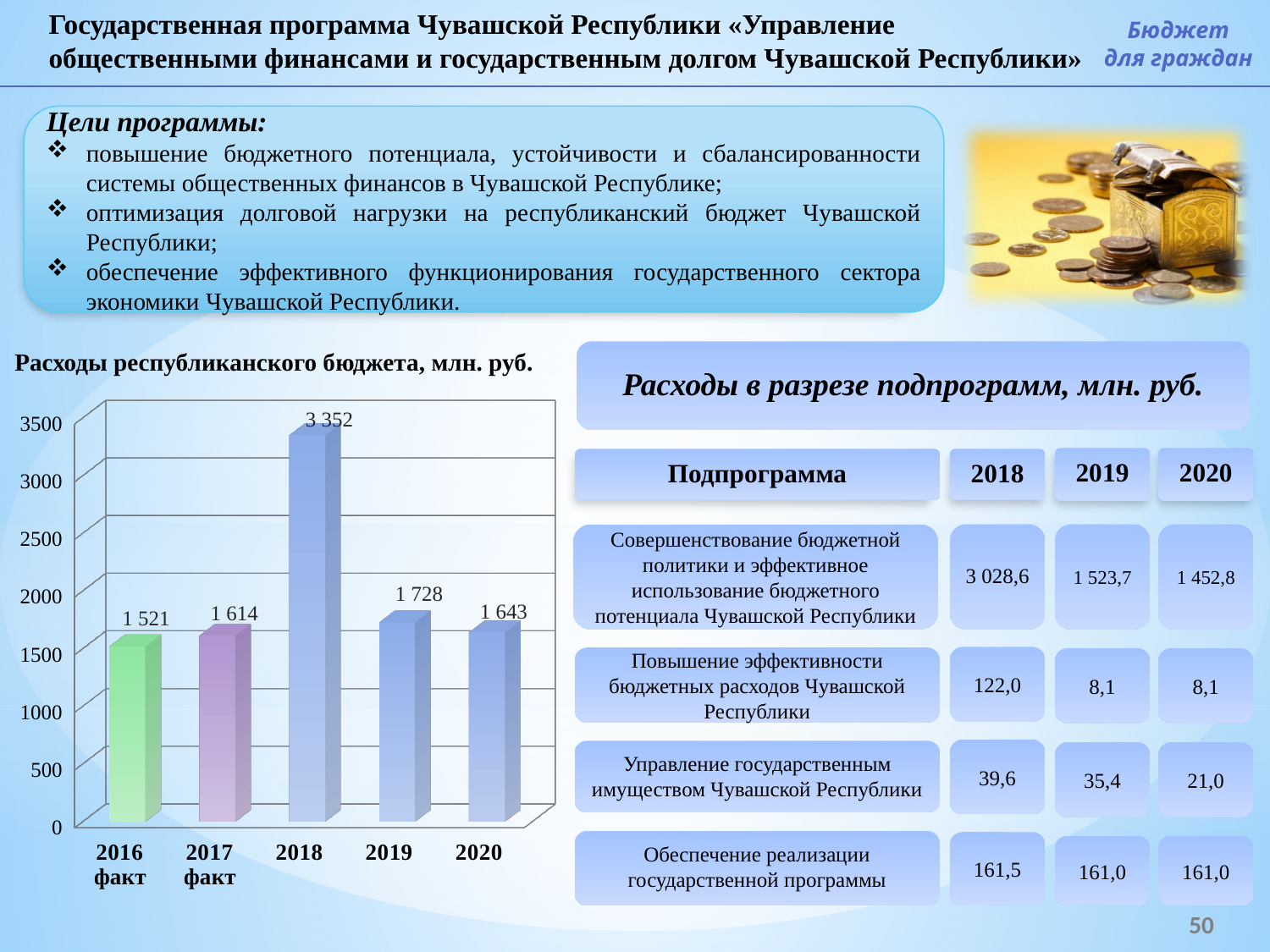
In the chart "Расходы республиканского бюджета, млн. руб.", which is larger: the value for 2019 or the value for 2020? 2019 How many bars are shown in the chart "Расходы республиканского бюджета, млн. руб."? 5 In the chart "Расходы республиканского бюджета, млн. руб.", what is the difference between the values for 2018 and 2019? 1 624 What kind of chart is "Расходы республиканского бюджета, млн. руб."? bar chart What is the value for 2018 in the chart "Расходы республиканского бюджета, млн. руб."? 3 352 What is the value for 2020 in the chart "Расходы республиканского бюджета, млн. руб."? 1 643 In the chart "Расходы республиканского бюджета, млн. руб.", what is the difference between the values for 2017 факт and 2016 факт? 93 What is the value for 2016 факт in the chart "Расходы республиканского бюджета, млн. руб."? 1 521 Which year has the lowest value in the chart "Расходы республиканского бюджета, млн. руб."? 2016 факт Which year has the highest value in the chart "Расходы республиканского бюджета, млн. руб."? 2018 In the chart "Расходы республиканского бюджета, млн. руб.", is the value for 2018 greater or less than 3000? greater In the chart "Расходы республиканского бюджета, млн. руб.", does the value rise or fall from 2018 to 2019? fall